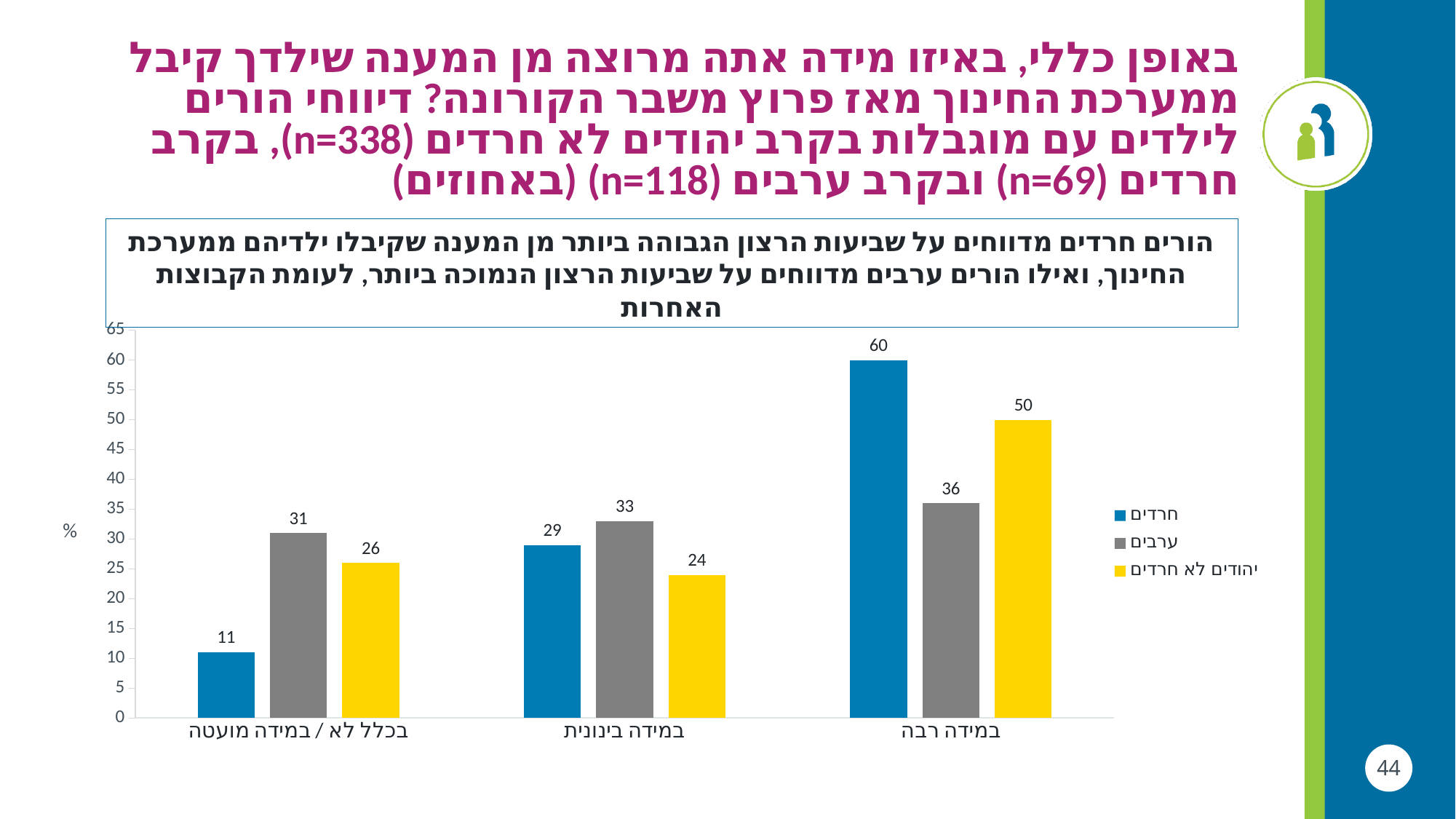
Which series has the lowest value in the בכלל לא / במידה מועטה category? חרדים What is the value for חרדים in the במידה רבה category? 60 What is the value for ערבים in the בכלל לא / במידה מועטה category? 31 Which is larger in the במידה בינונית category: the value for ערבים or the value for חרדים? ערבים Is the value for יהודים לא חרדים in the במידה רבה category greater or less than 40? greater Which series has the highest value in the במידה רבה category? חרדים How many categories are shown on the x axis? 3 What colour are the bars for the ערבים series? gray What kind of chart is shown on the slide? bar chart How many series does the legend list? 3 What is the value for יהודים לא חרדים in the במידה בינונית category? 24 What is the difference between the חרדים and ערבים values in the במידה רבה category? 24